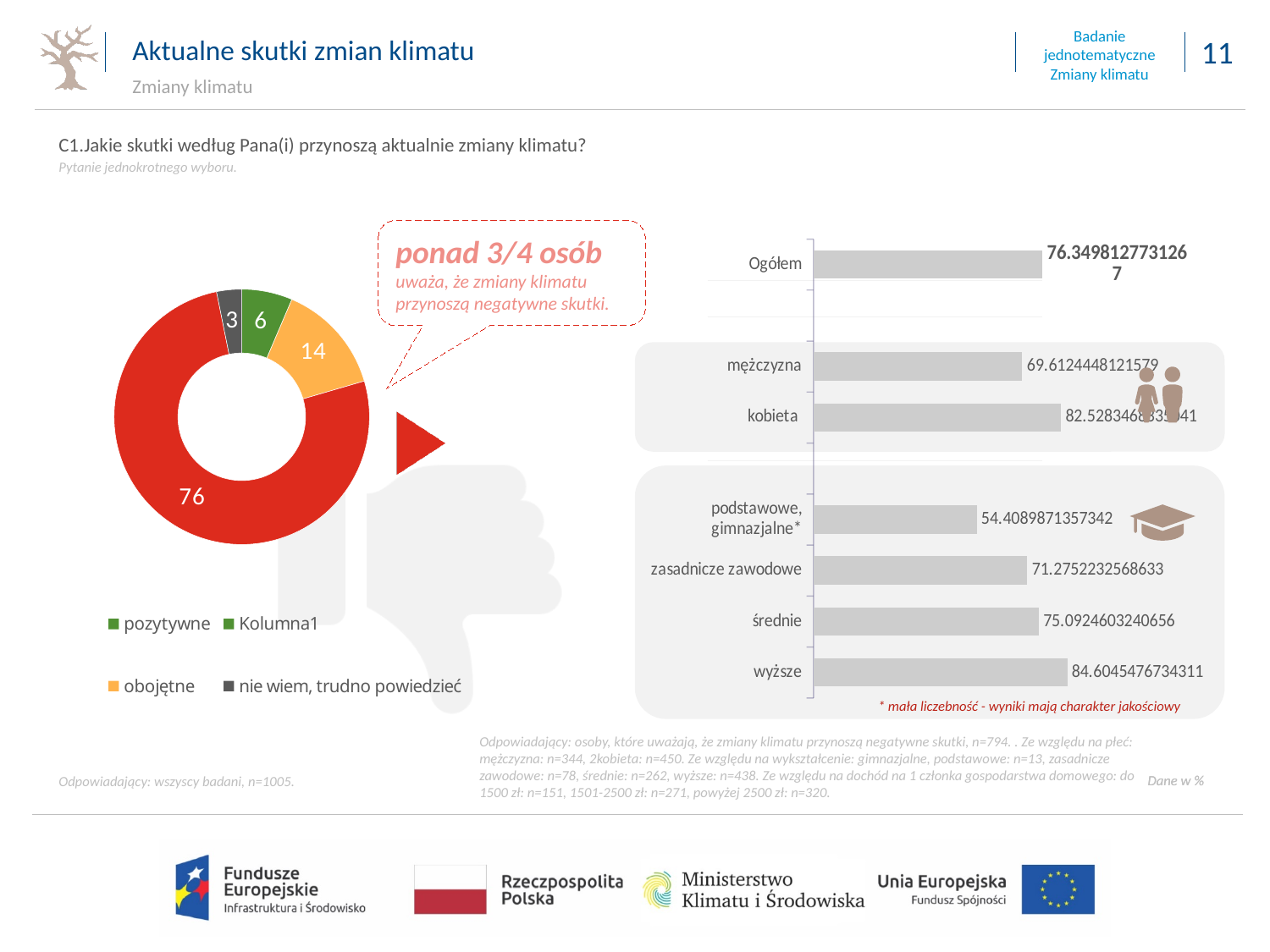
In the bar chart on the right, which is larger, the value for mężczyzna or for kobieta? kobieta In the bar chart on the right, what is the value for wyższe? 84.6045476734311 In the bar chart on the right, what is the difference between the values for wyższe and podstawowe, gimnazjalne*? 30.1955605376969 How many categories are shown in the bar chart on the right? 7 In the donut chart on the left, what is the value for obojętne? 14 In the donut chart on the left, what is the value of the largest slice? 76 In the bar chart on the right, what is the value for mężczyzna? 69.6124448121579 In the donut chart on the left, what is the value for nie wiem, trudno powiedzieć? 3 In the bar chart on the right, which category has the highest value? wyższe In the bar chart on the right, which category has the lowest value? podstawowe, gimnazjalne* In the bar chart on the right, what is the value for średnie? 75.0924603240656 In the bar chart on the right, what is the value for zasadnicze zawodowe? 71.2752232568633